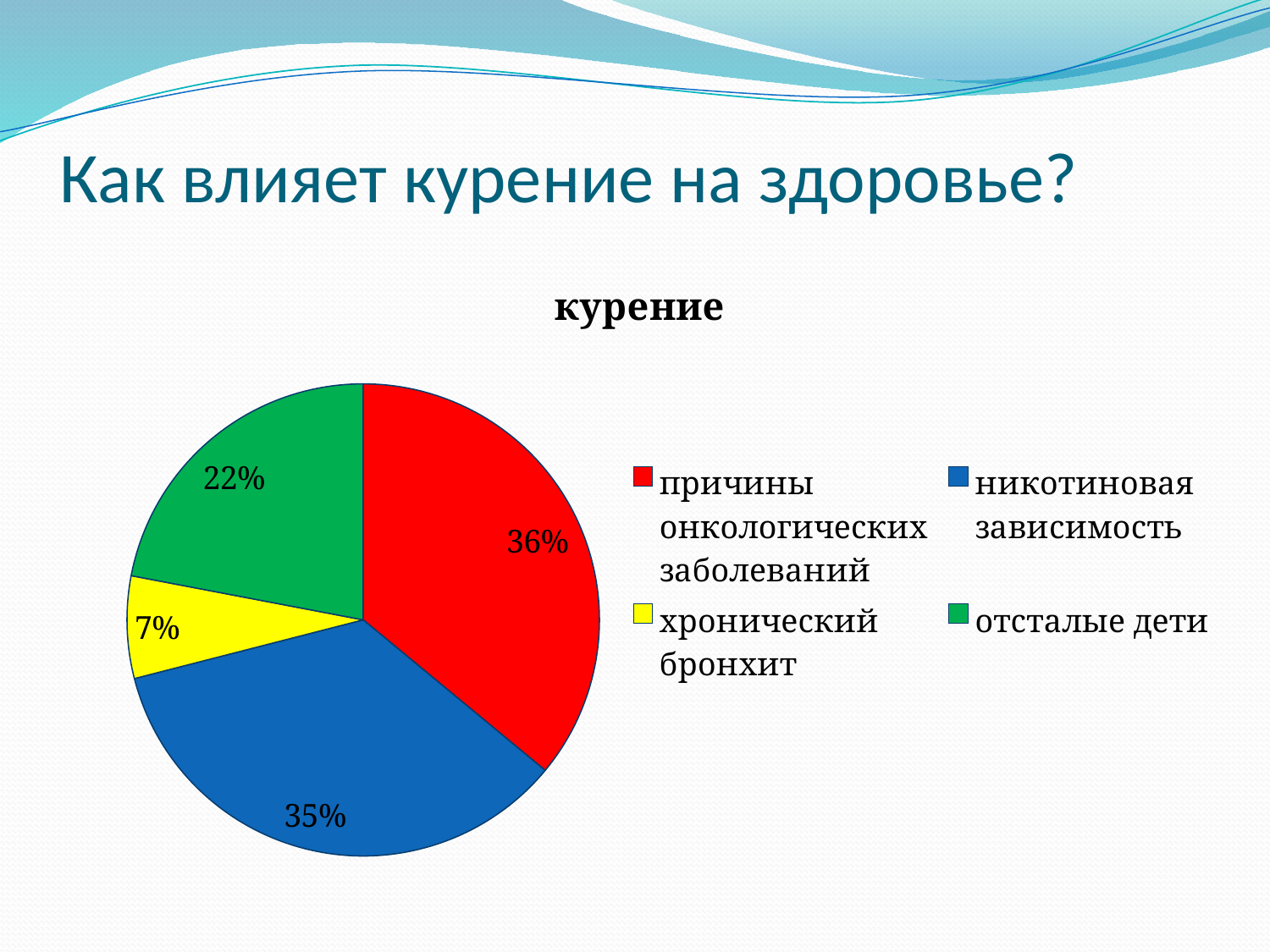
What is the title of the chart? курение What share of the pie is "отсталые дети"? 22% Which category has the smallest slice of the pie? хронический бронхит Which colour represents "никотиновая зависимость" in the pie chart? blue How many entries does the legend list? 4 What is the difference in percentage points between "отсталые дети" and "хронический бронхит"? 15 What kind of chart is shown on the slide? pie chart Which category has the largest slice of the pie? причины онкологических заболеваний What share of the pie is "хронический бронхит"? 7% What share of the pie is "никотиновая зависимость"? 35% How many slices does the pie chart have? 4